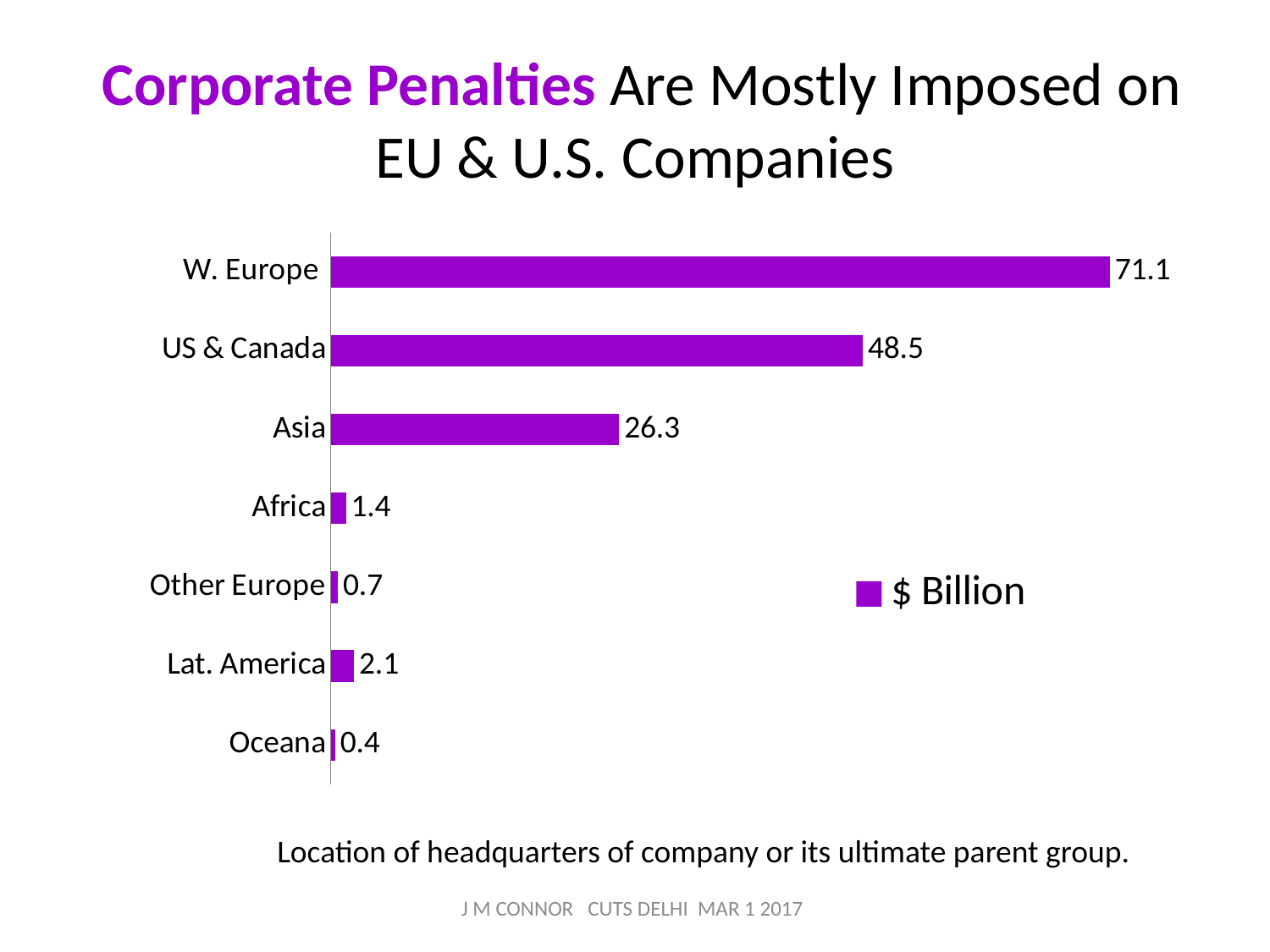
Which is larger, the value for Lat. America or the value for Africa? Lat. America Which region has the highest value? W. Europe What is the value for Lat. America? 2.1 What is the value for W. Europe? 71.1 What is the difference between the values for W. Europe and US & Canada? 22.6 What kind of chart is shown on the slide? bar chart How many series does the legend list? 1 How many regions are shown in the chart? 7 What is the difference between the values for Africa and Other Europe? 0.7 What is the value for Asia? 26.3 What is the legend entry for the series in the chart? $ Billion Which region has the lowest value? Oceana